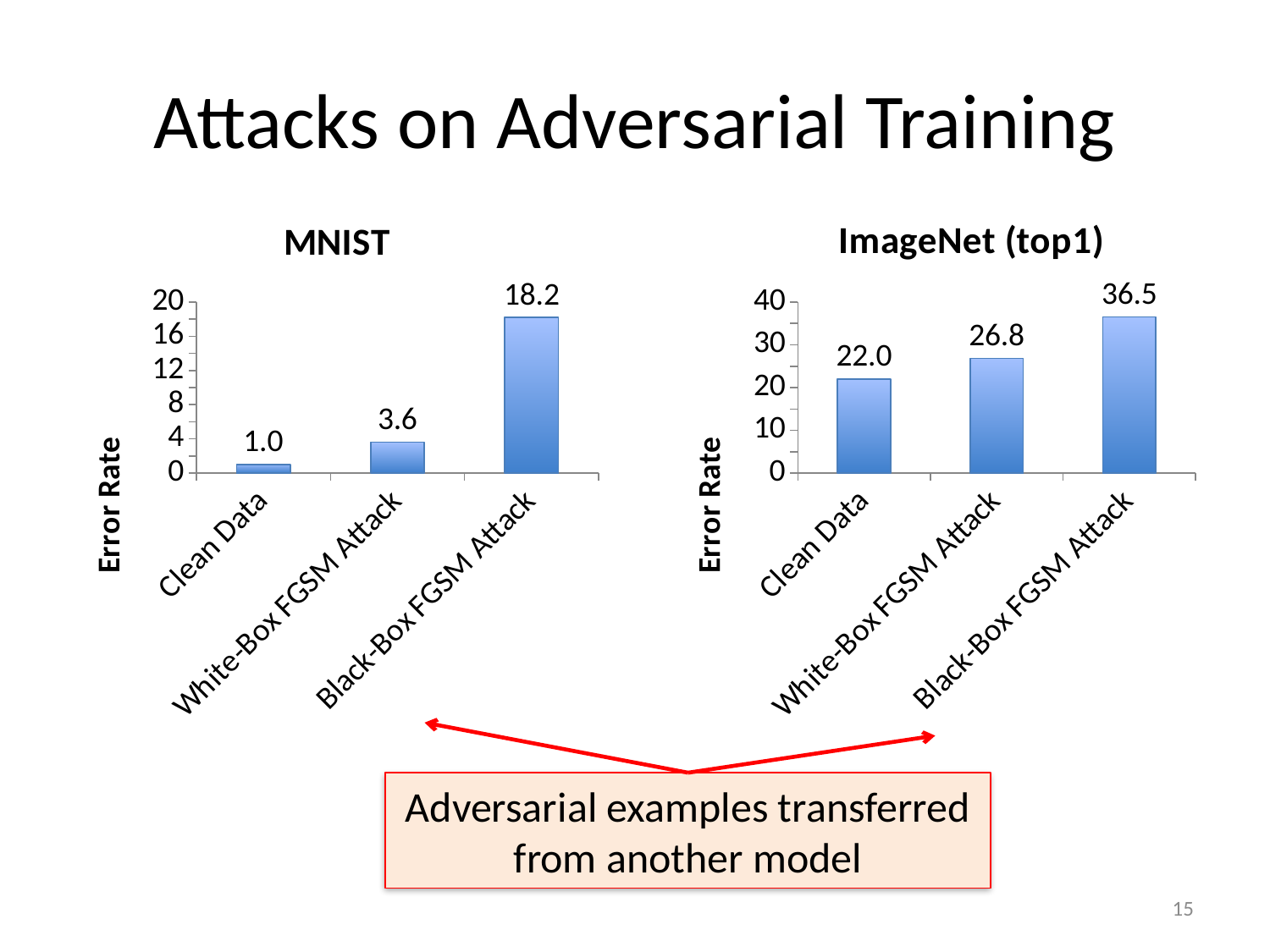
In the MNIST chart, which category has the highest error rate? Black-Box FGSM Attack In the ImageNet (top1) chart, which category has the lowest error rate? Clean Data In the ImageNet (top1) chart, what is the difference in error rate between the White-Box FGSM Attack and Clean Data? 4.8 In the MNIST chart, what is the error rate for the White-Box FGSM Attack? 3.6 In the MNIST chart, what is the error rate for Clean Data? 1.0 What type of chart is the ImageNet (top1) chart? Bar chart In the MNIST chart, do the error rates rise or fall from Clean Data to Black-Box FGSM Attack? Rise In the ImageNet (top1) chart, what is the error rate for Clean Data? 22.0 In the ImageNet (top1) chart, what is the error rate for the Black-Box FGSM Attack? 36.5 How many categories are shown in the MNIST chart? 3 In the ImageNet (top1) chart, which has a higher error rate, the White-Box FGSM Attack or the Black-Box FGSM Attack? Black-Box FGSM Attack In the MNIST chart, what is the difference in error rate between the Black-Box FGSM Attack and the White-Box FGSM Attack? 14.6